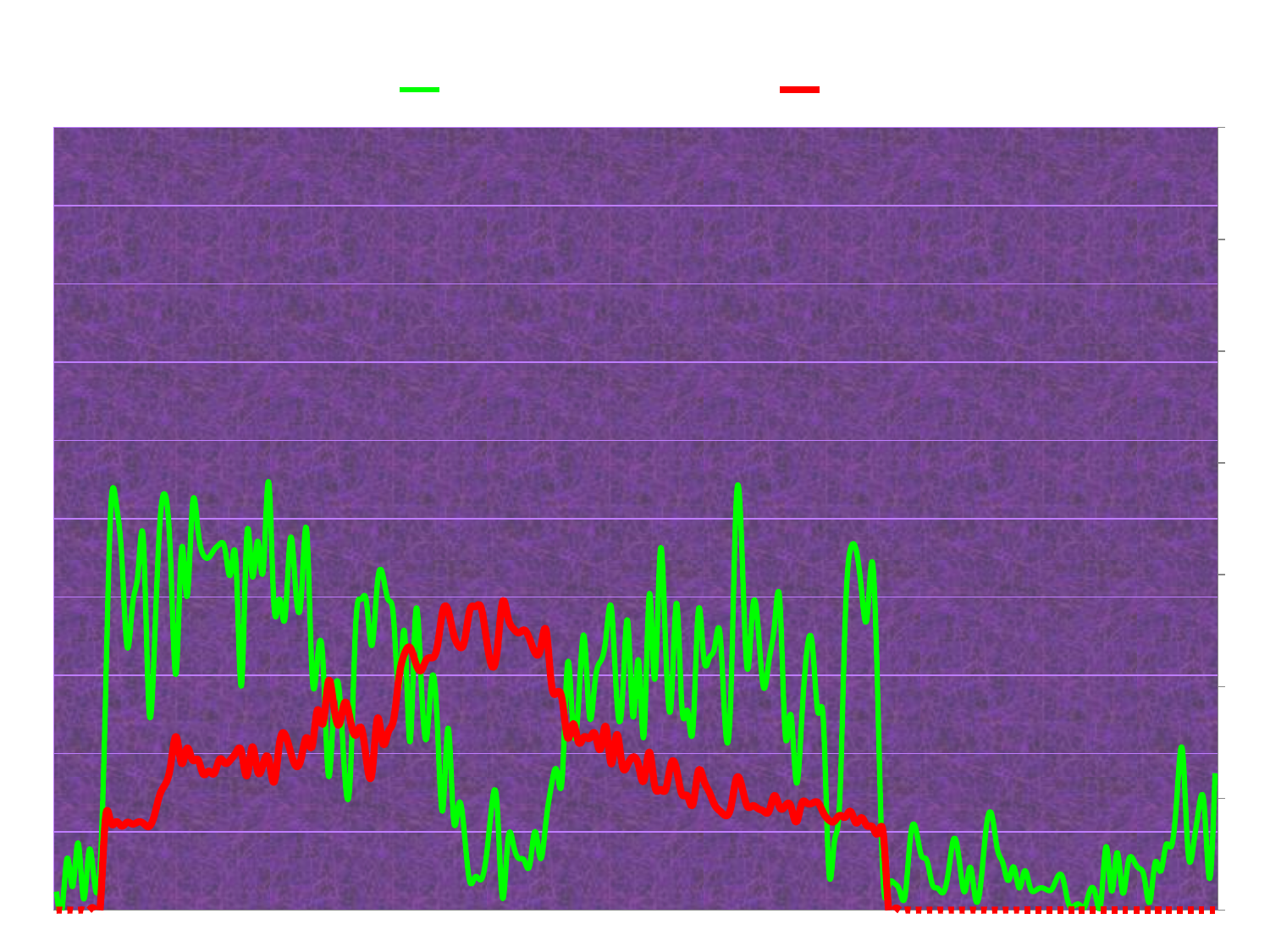
Does the red line rise or fall over the final portion of the x axis? fall Which series reaches the higher peak on the chart, the green line or the red line? green What colours are the two lines plotted on the chart? green and red How many series does the legend list? 2 Which series sits flat along the bottom of the chart at the right-hand end, the green line or the red line? red What kind of chart is shown on the slide? line chart